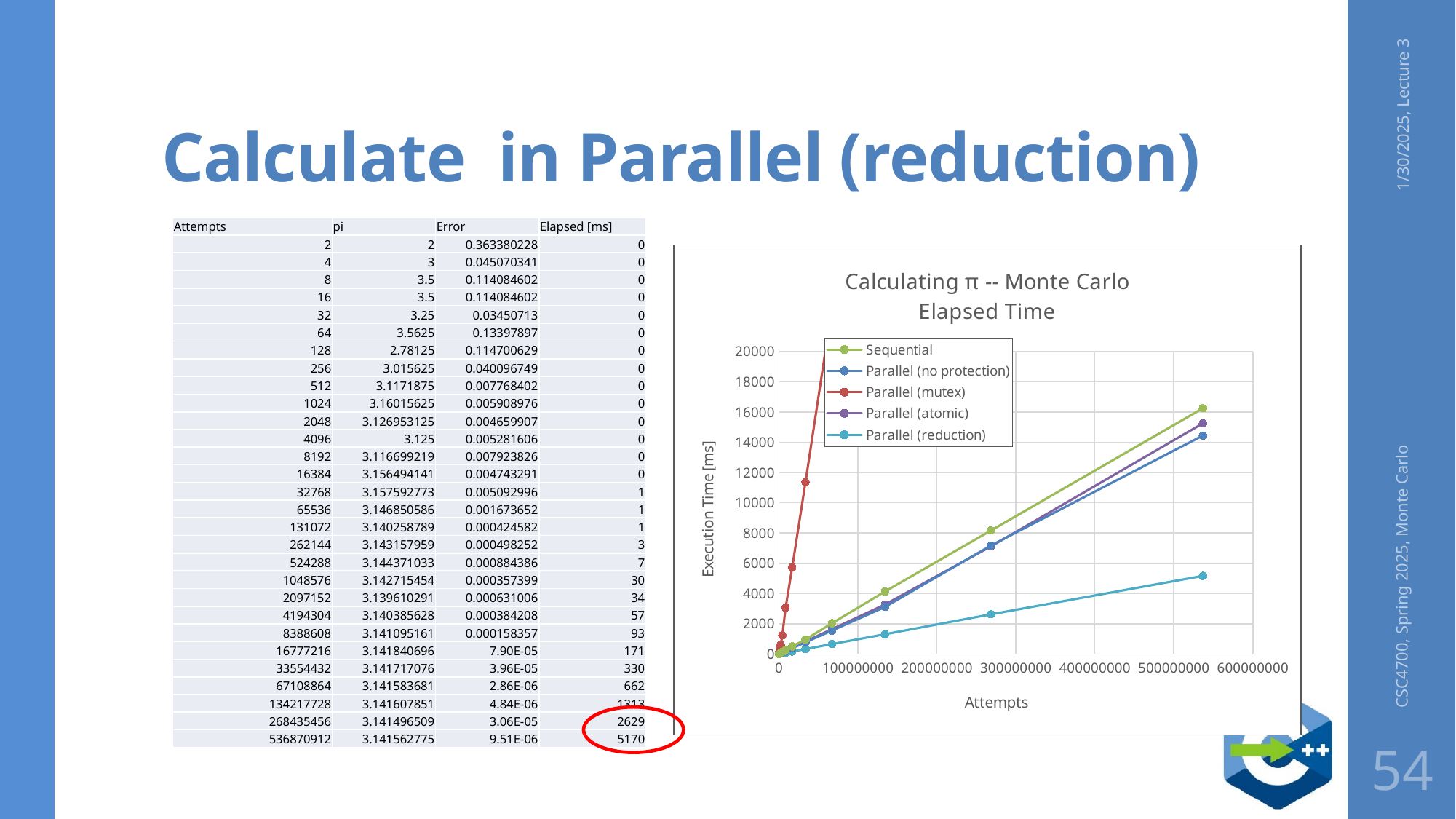
What kind of chart is shown on the slide? line chart What is the label of the y axis of the chart? Execution Time [ms] Is the execution time for Parallel (reduction) at its rightmost point greater or less than 6000? less At the rightmost plotted point, which has the larger execution time: Sequential or Parallel (reduction)? Sequential Which series has the lowest execution time at the largest number of attempts plotted? Parallel (reduction) Is the execution time for Sequential at its rightmost point greater or less than 14000? greater What is the title of the chart? Calculating π -- Monte Carlo Elapsed Time Does the execution time for Sequential rise or fall as the number of attempts increases? rise Is the execution time for Parallel (no protection) at its rightmost point greater or less than 10000? greater How many series does the chart legend list? 5 Which series rises so steeply that it goes above the top of the y axis (20000)? Parallel (mutex)